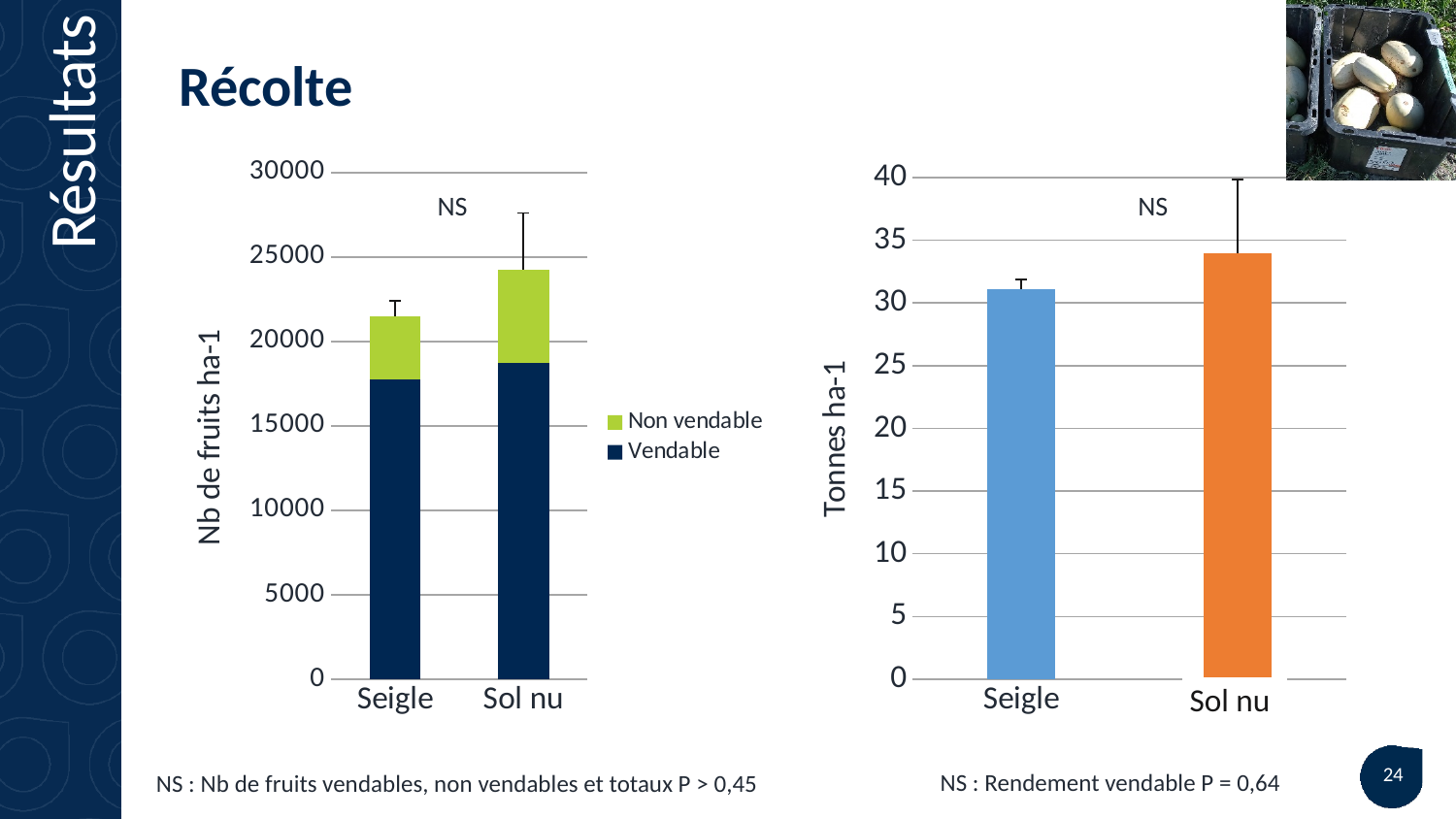
In the right chart, is the value for Sol nu greater or less than 35? less In the left chart, is the total bar height for Sol nu greater or less than 25000? less How many categories are shown on the x axis of the right chart? 2 In the left chart, which category has the taller total bar, Seigle or Sol nu? Sol nu In the left chart, is the total bar height for Seigle greater or less than 20000? greater What is the y-axis title of the right chart? Tonnes ha-1 In the left chart, which legend entry is shown in green? Non vendable What kind of chart is the right chart (Tonnes ha-1)? bar chart How many series does the legend of the left chart list? 2 In the right chart, which category has the higher value, Seigle or Sol nu? Sol nu What kind of chart is the left chart (Nb de fruits ha-1)? stacked bar chart